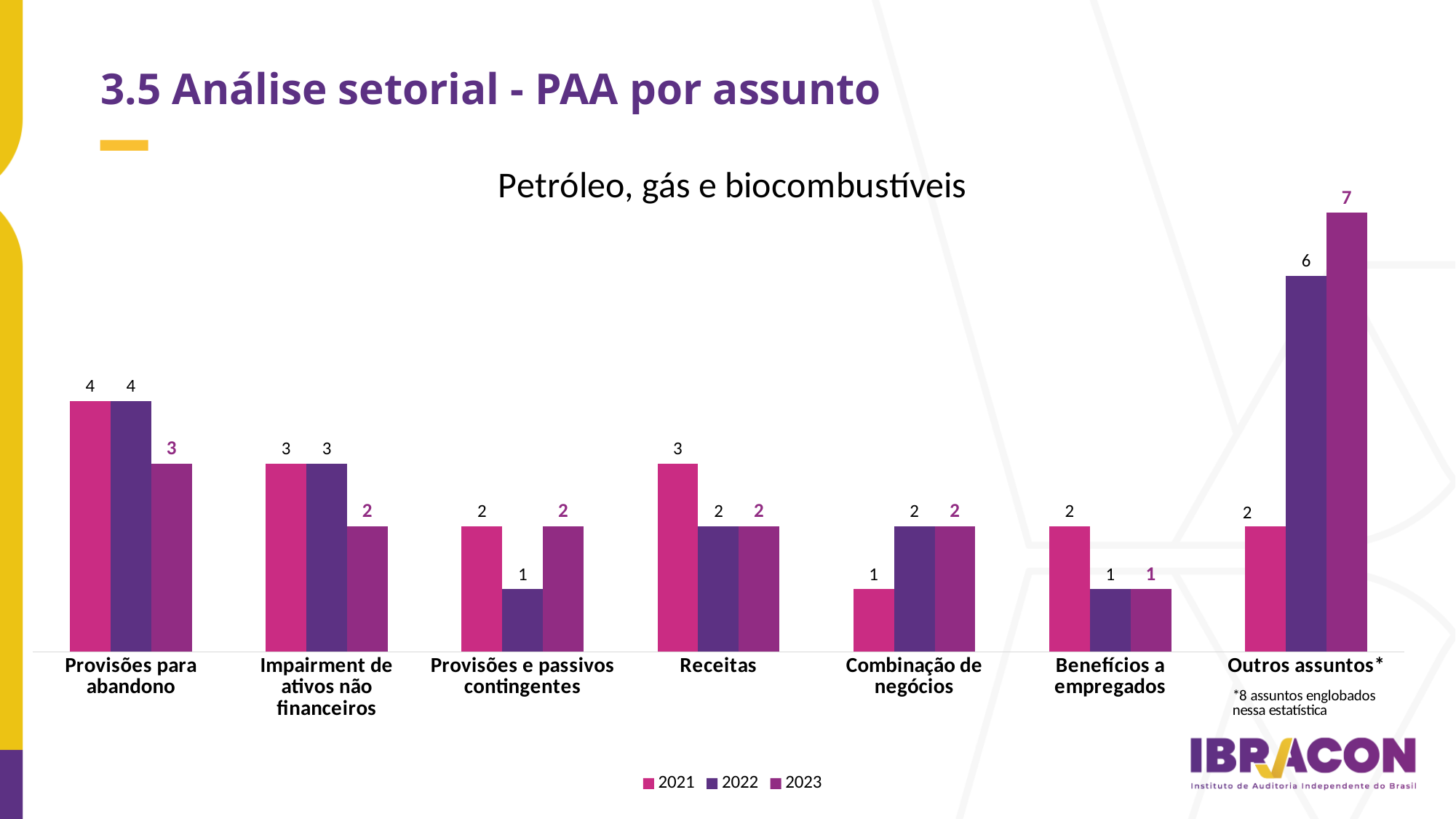
What kind of chart is shown on the slide? Bar chart Which category has the highest value in 2023? Outros assuntos* How many categories are shown on the x axis? 7 Which category has the lowest value in 2021? Combinação de negócios What is the value for Receitas in 2021? 3 What is the value for Outros assuntos* in 2023? 7 Which is larger for Benefícios a empregados: the 2021 value or the 2022 value? 2021 How many series does the legend list? 3 What is the title of the chart? Petróleo, gás e biocombustíveis What is the value for Provisões e passivos contingentes in 2022? 1 Do the values for Provisões para abandono rise or fall from 2021 to 2023? Fall What is the difference between the 2023 and 2021 values for Outros assuntos*? 5